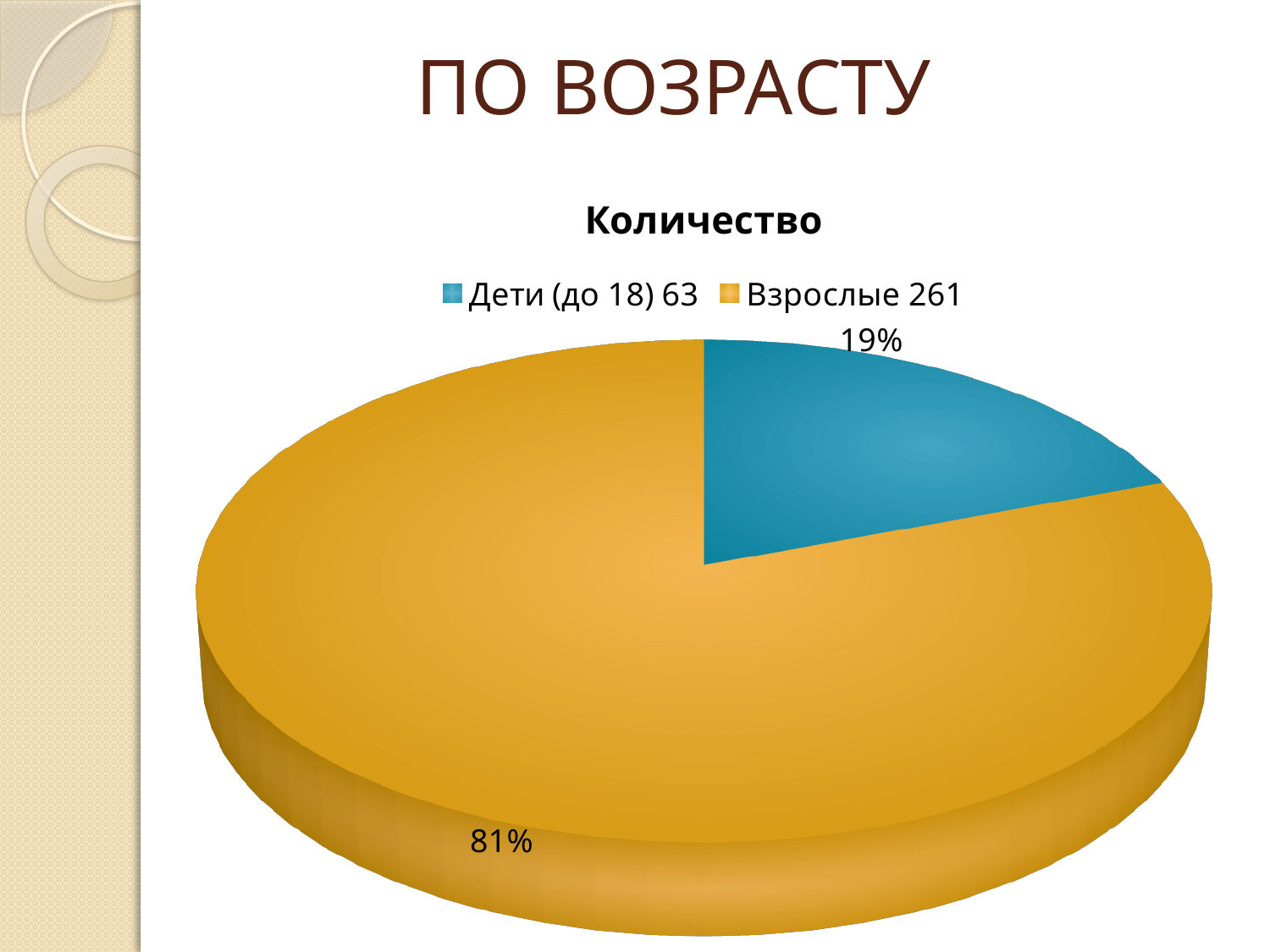
What kind of chart is shown on the slide? pie chart What is the difference in percentage points between the Взрослые share and the Дети (до 18) share? 62 Which category has the largest slice of the pie? Взрослые What share of the pie does the slice for Взрослые represent? 81% What share of the pie does the slice for Дети (до 18) represent? 19% What colour is the slice for Дети (до 18)? blue How many slices does the pie chart have? 2 Which is larger, the share for Дети (до 18) or the share for Взрослые? Взрослые Which category has the smallest slice of the pie? Дети (до 18) What is the title of the chart? Количество How many entries does the legend list? 2 What number is shown next to Взрослые in the legend? 261